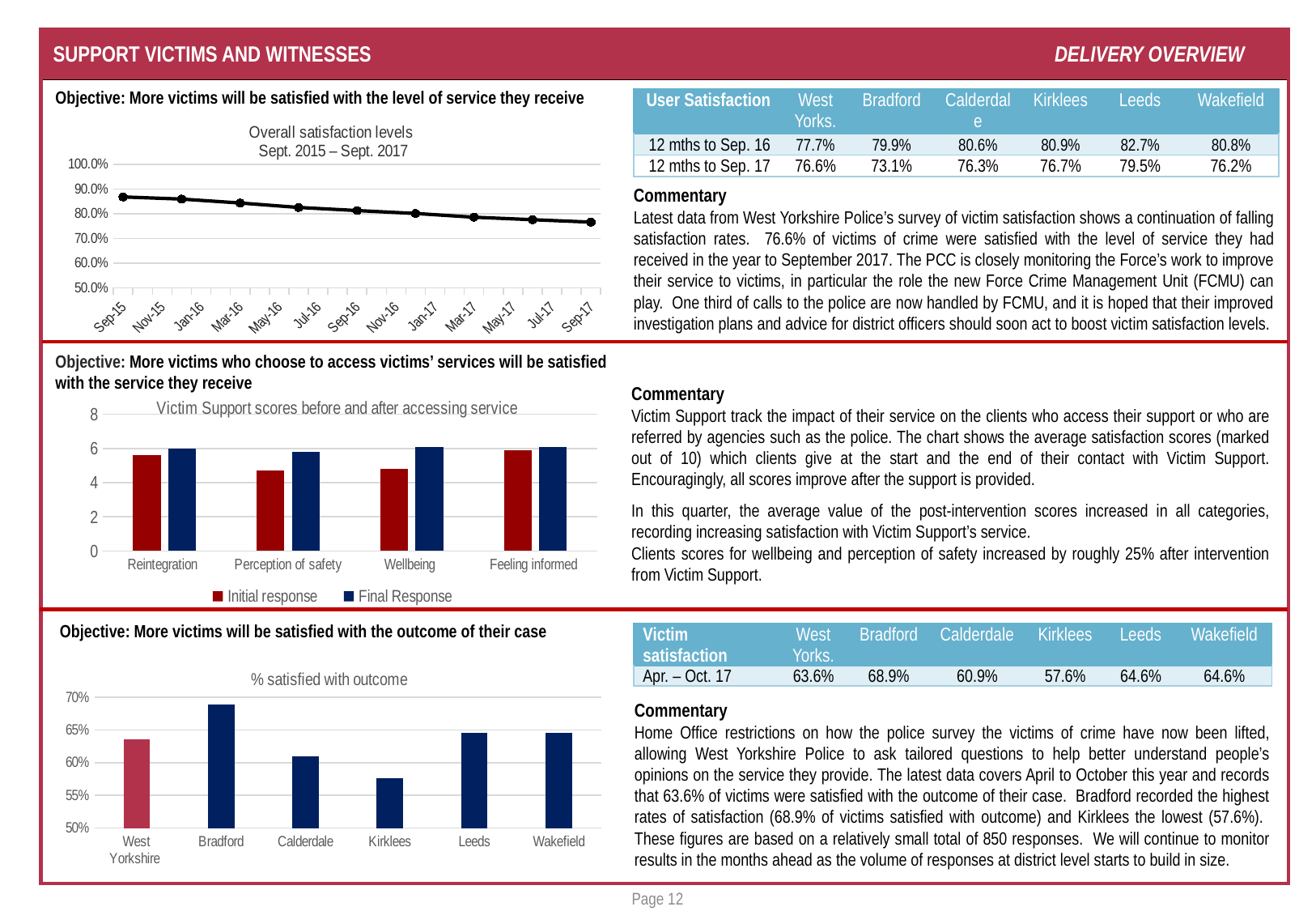
In the 'Overall satisfaction levels' chart, what kind of chart is shown? line chart In the '% satisfied with outcome' chart, which category has the lowest value? Kirklees In the 'Victim Support scores before and after accessing service' chart, which is larger for Wellbeing: Initial response or Final Response? Final Response In the 'Victim Support scores before and after accessing service' chart, how many series does the legend list? 2 In the '% satisfied with outcome' chart, which category has the highest value? Bradford In the 'Victim Support scores before and after accessing service' chart, how many categories are shown on the x axis? 4 In the 'Overall satisfaction levels' chart, is the value for Sep-17 greater or less than 80.0%? less In the '% satisfied with outcome' chart, is the value for Kirklees greater or less than 60%? less In the '% satisfied with outcome' chart, what kind of chart is shown? bar chart In the 'Victim Support scores before and after accessing service' chart, is the Initial response value for Perception of safety greater or less than 6? less In the 'Overall satisfaction levels' chart, do the values rise or fall from Sep-15 to Sep-17? fall